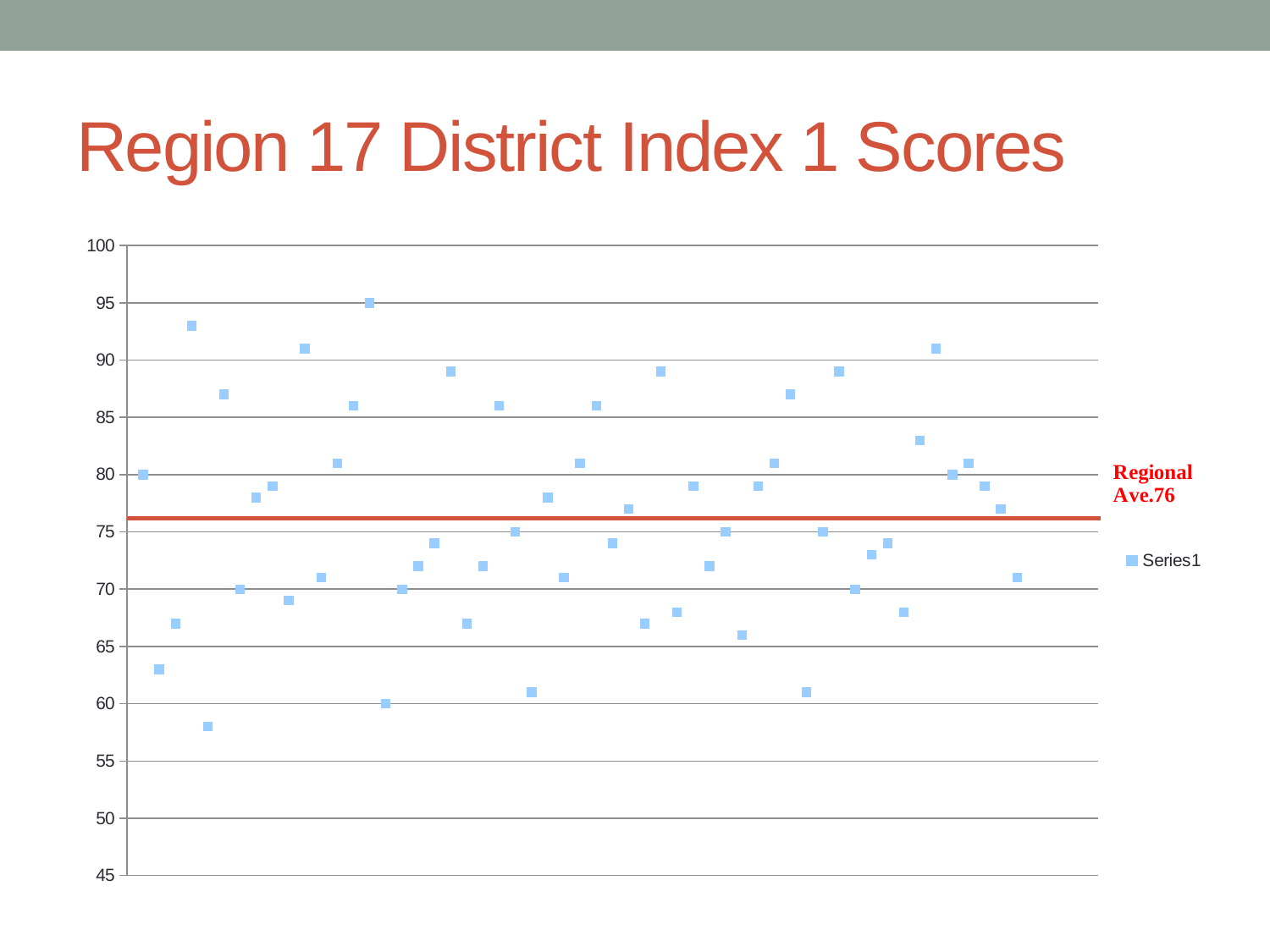
What is the name of the series listed in the legend? Series1 Is the regional average shown on the chart greater or less than 80? less Is the lowest plotted score greater or less than the regional average of 76? less What value is given for the regional average marked by the horizontal line? 76 What kind of chart is shown on the slide? scatter chart How many series does the legend list? 1 What is the title of the chart? Region 17 District Index 1 Scores What is the value of the highest plotted point on the chart? 95 Is the lowest plotted score greater or less than 60? less Is the highest plotted score greater or less than 90? greater